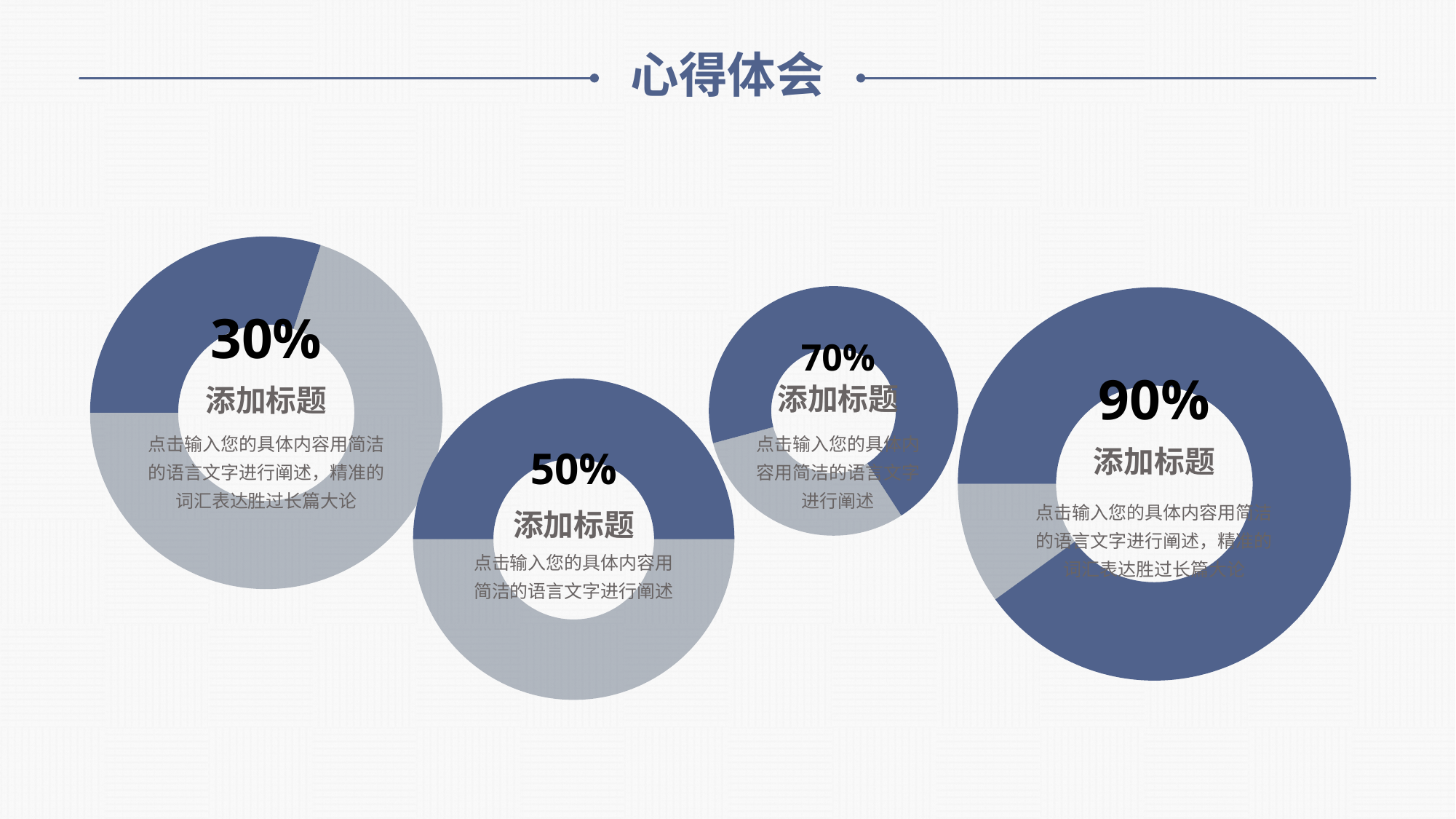
In the second donut chart from the left, what share of the ring is filled in dark blue? 50% What percentage is shown in the second donut chart from the left? 50% Which donut chart shows the lowest percentage? The leftmost chart (30%) What kind of chart is used on this slide? Donut chart What percentage is shown in the rightmost donut chart? 90% What is the title of the slide? 心得体会 Which is larger: the percentage in the second donut chart from the left or the percentage in the third donut chart from the left? The third chart (70%) What percentage is shown in the third donut chart from the left? 70% What percentage is shown in the leftmost donut chart? 30% What is the difference between the percentage in the rightmost donut chart and the percentage in the leftmost donut chart? 60% How many donut charts are on the slide? 4 Which donut chart shows the highest percentage? The rightmost chart (90%)